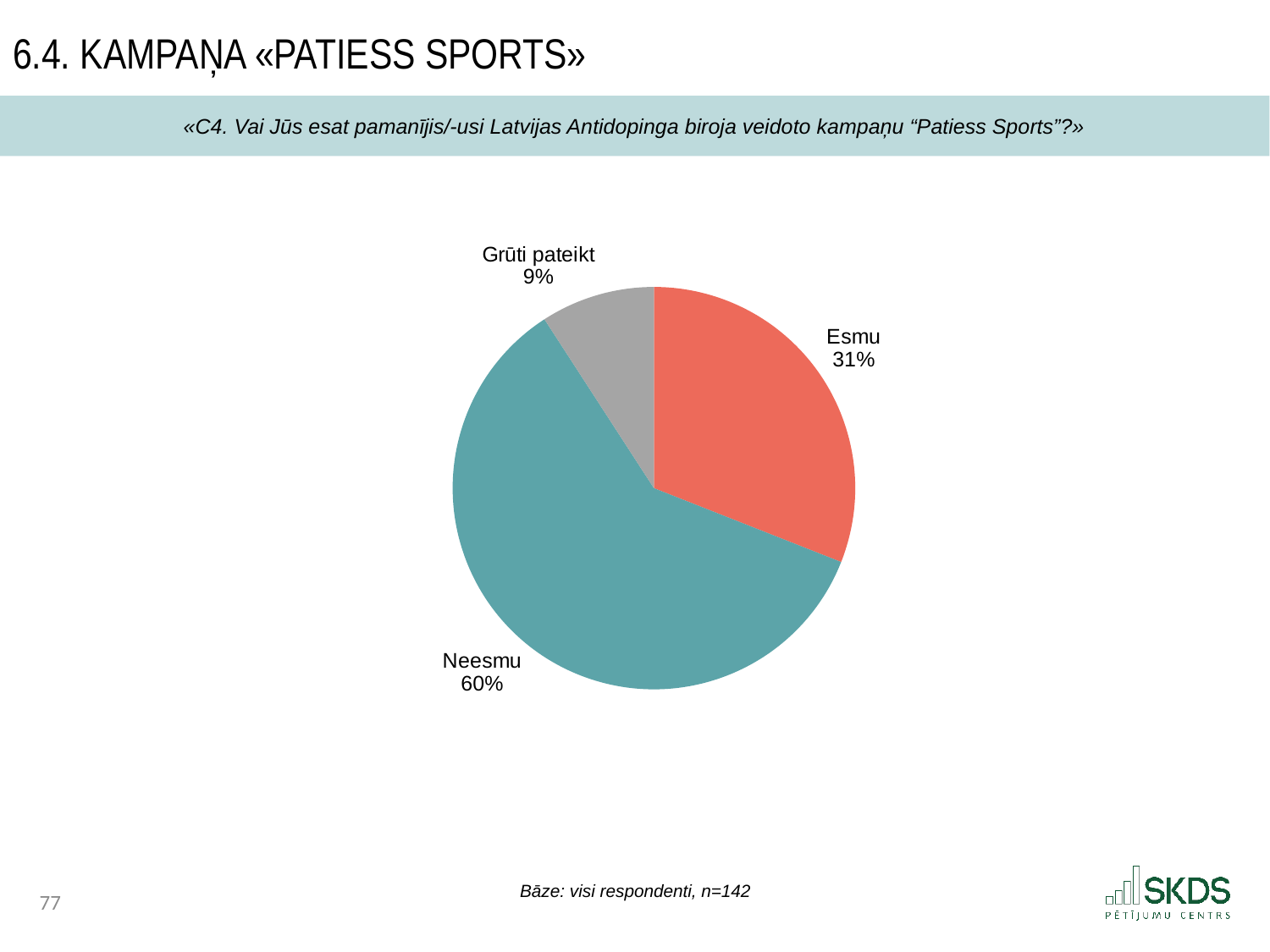
What is the difference in percentage points between "Neesmu" and "Esmu"? 29 What kind of chart is shown on the slide? pie chart Which answer has the smallest share of the pie? Grūti pateikt Which answer has the largest share of the pie? Neesmu Which is larger, the share for "Esmu" or the share for "Grūti pateikt"? Esmu What share of respondents answered "Neesmu"? 60% What share of respondents answered "Esmu"? 31% What is the base (number of respondents) stated below the chart? n=142 How many slices does the pie chart have? 3 What share of respondents answered "Grūti pateikt"? 9% What colour is the "Neesmu" slice? teal What is the combined share of "Esmu" and "Grūti pateikt"? 40%